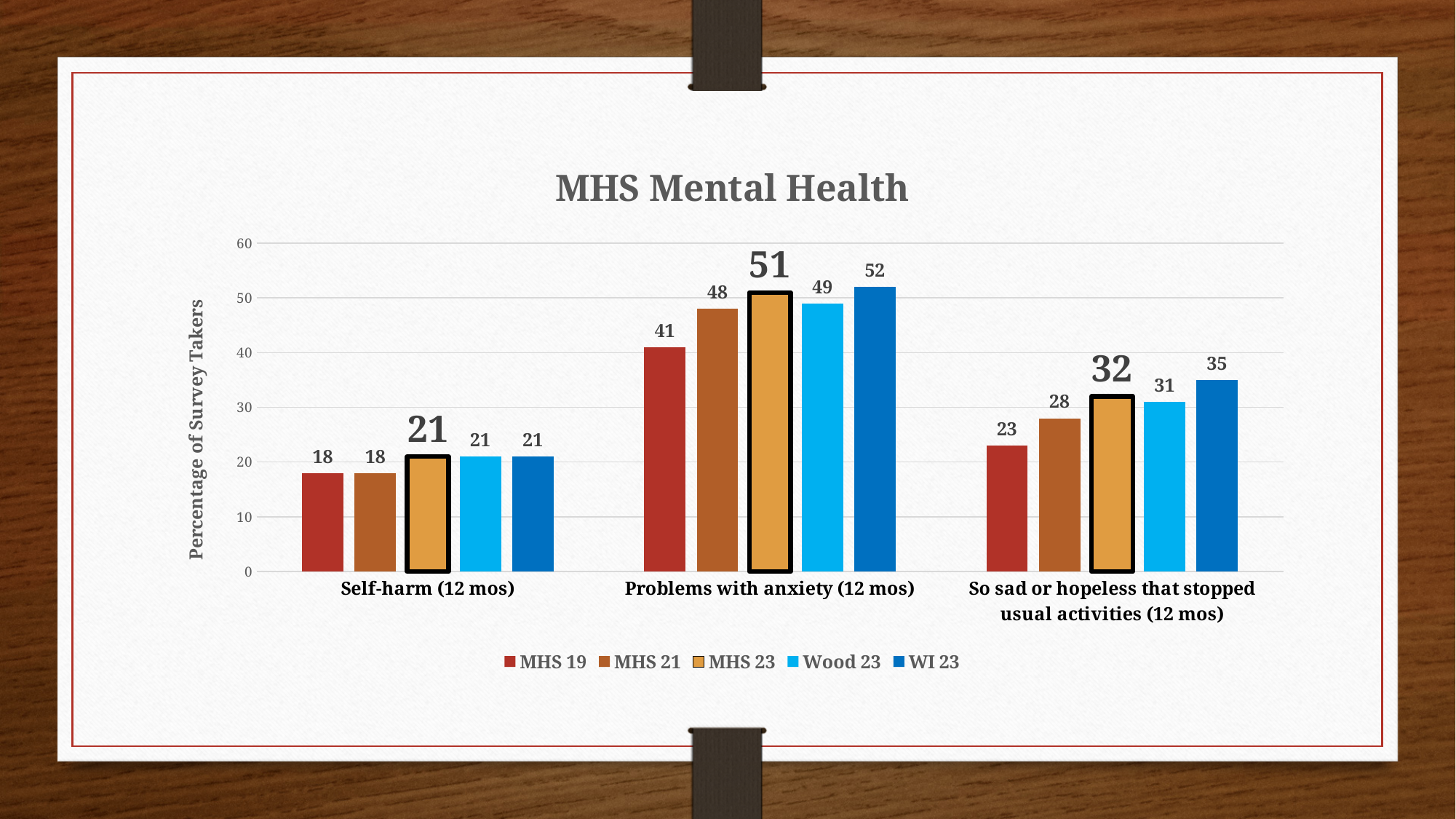
What is the title of the chart? MHS Mental Health How many categories are shown on the x axis? 3 What kind of chart is shown on the slide? Bar chart Which series has the highest value in the Problems with anxiety (12 mos) category? WI 23 What is the value for MHS 19 in the Self-harm (12 mos) category? 18 What is the value for WI 23 in the So sad or hopeless that stopped usual activities (12 mos) category? 35 How many series does the legend list? 5 What is the difference between the WI 23 and MHS 19 values in the Problems with anxiety (12 mos) category? 11 Which series has the lowest value in the So sad or hopeless that stopped usual activities (12 mos) category? MHS 19 What is the label of the vertical axis? Percentage of Survey Takers What is the value for MHS 23 in the Problems with anxiety (12 mos) category? 51 Which is larger in the So sad or hopeless that stopped usual activities (12 mos) category: MHS 21 or Wood 23? Wood 23